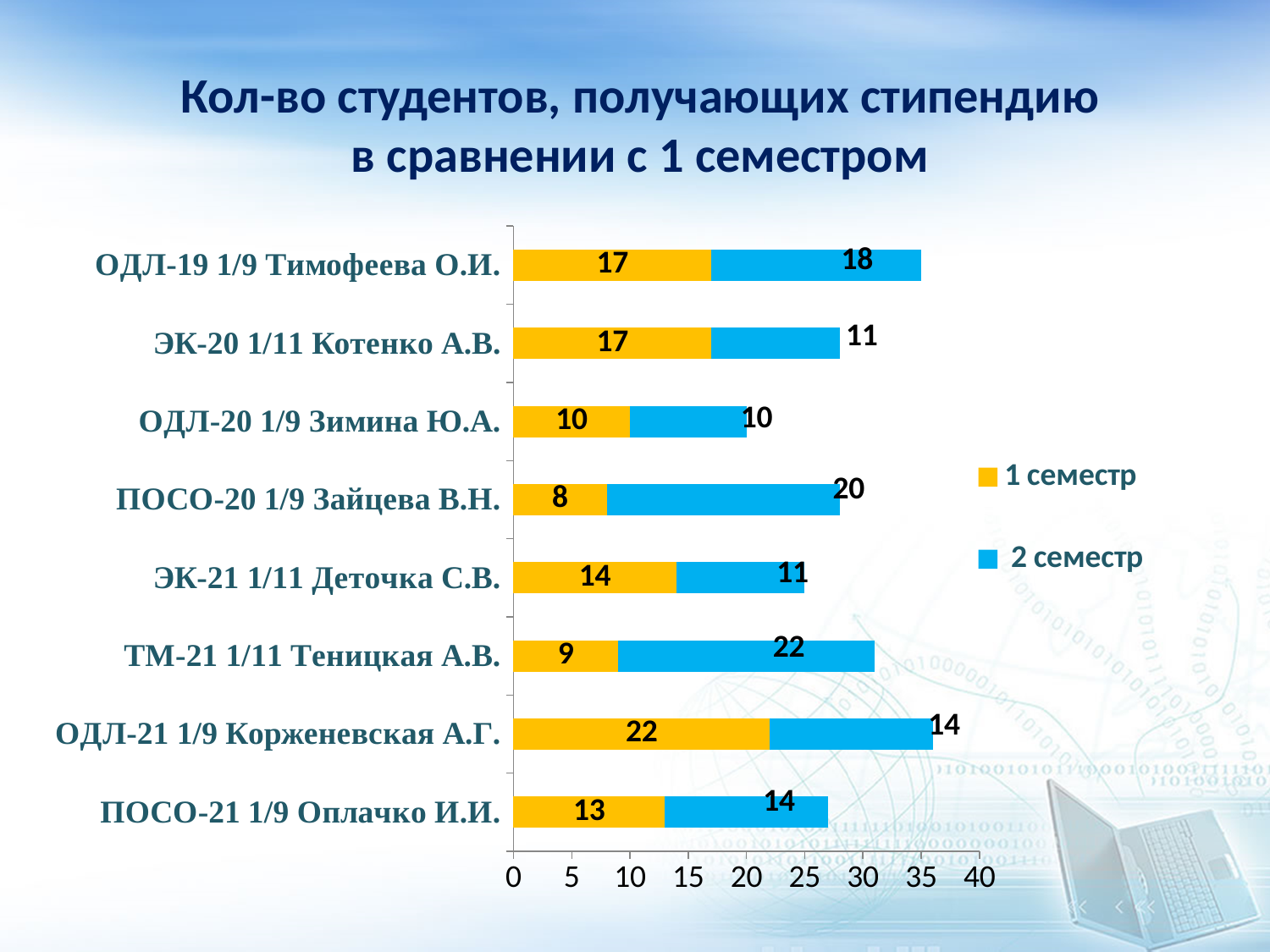
Which category has the lowest value for "1 семестр"? ПОСО-20 1/9 Зайцева В.Н. Which category has the lowest value for "2 семестр"? ОДЛ-20 1/9 Зимина Ю.А. How many series does the legend list? 2 Which category has the highest value for "1 семестр"? ОДЛ-21 1/9 Корженевская А.Г. What is the total of the stacked bar for ОДЛ-19 1/9 Тимофеева О.И.? 35 What is the difference between the "2 семестр" and "1 семестр" values for ПОСО-20 1/9 Зайцева В.Н.? 12 What is the value for "2 семестр" for ТМ-21 1/11 Теницкая А.В.? 22 How many categories are shown on the chart? 8 What is the value for "1 семестр" for ОДЛ-19 1/9 Тимофеева О.И.? 17 What kind of chart is shown on the slide? Stacked bar chart What is the value for "2 семестр" for ПОСО-20 1/9 Зайцева В.Н.? 20 Which is larger for ЭК-20 1/11 Котенко А.В.: the "1 семестр" value or the "2 семестр" value? 1 семестр